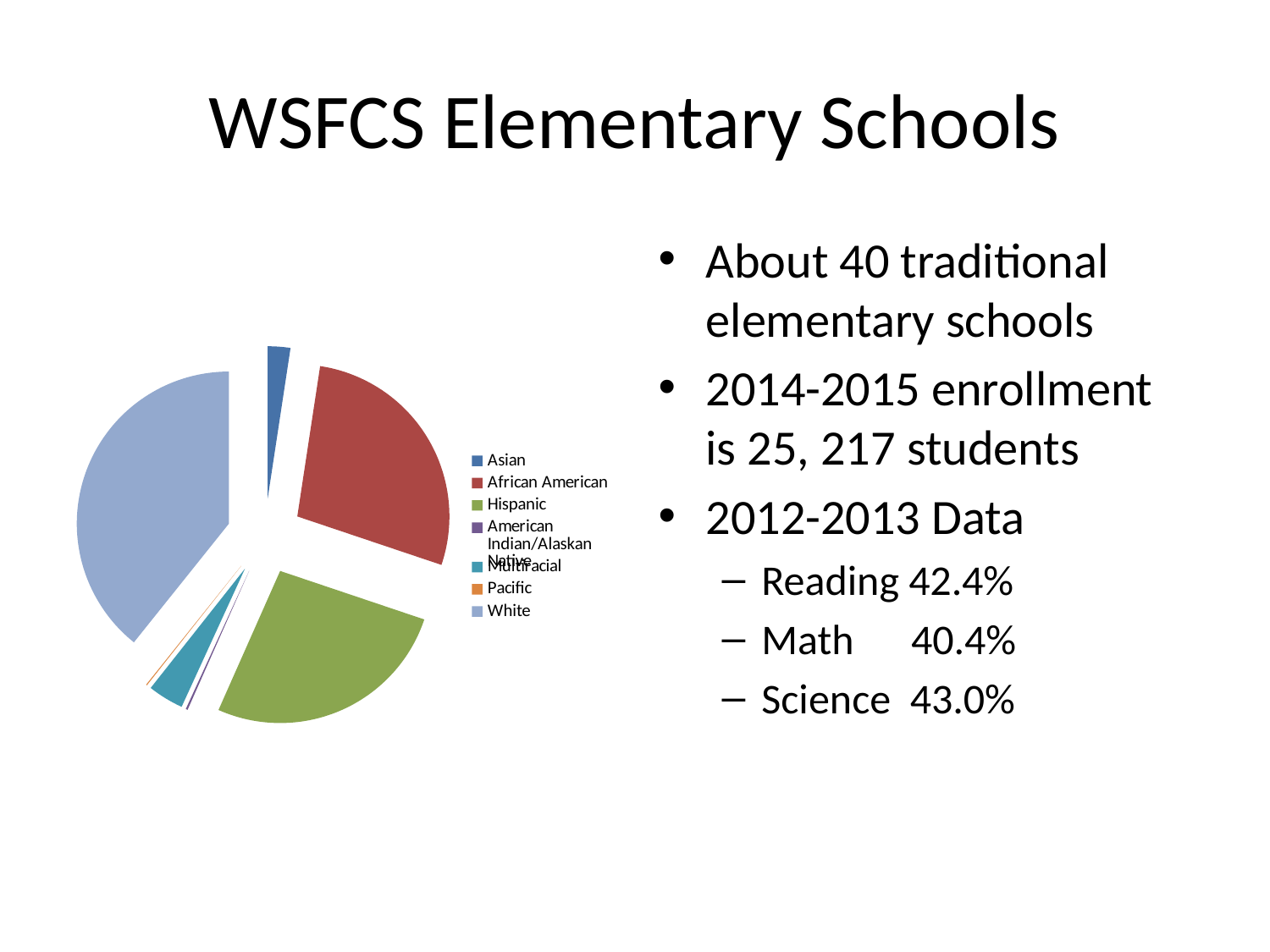
Which slice is larger, White or Hispanic? White Which slice is larger, White or Asian? White What colour is the African American slice of the pie chart? Red Which slice is larger, Hispanic or Asian? Hispanic How many categories does the pie chart's legend list? 7 What kind of chart is shown on the slide? Pie chart Which category has the largest slice of the pie chart? White What is the first category listed in the pie chart's legend? Asian